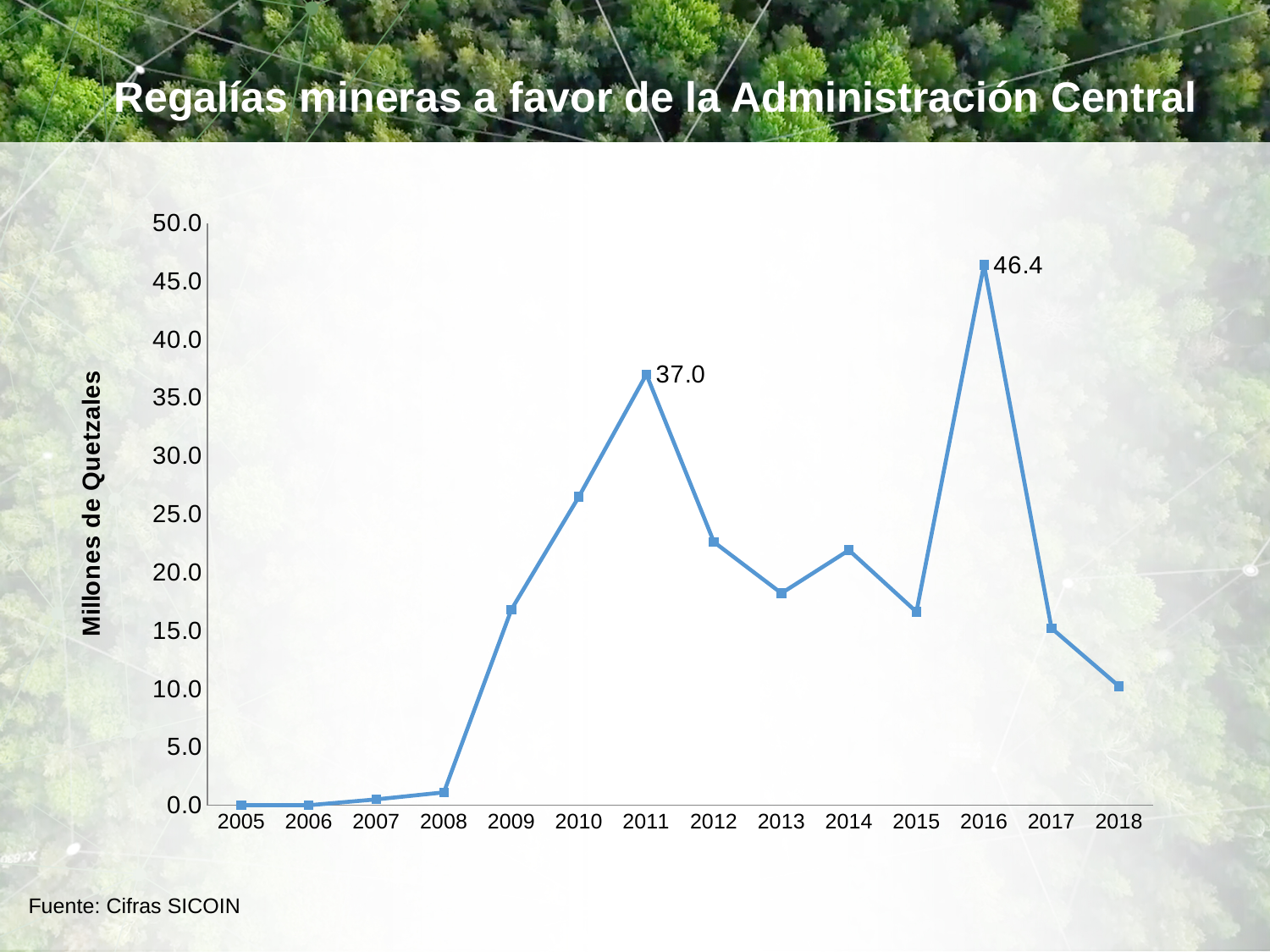
Is the value for 2010 greater or less than 20.0? greater Is the value for 2008 greater or less than 5.0? less Which is larger, the value for 2011 or the value for 2016? 2016 What is the value for 2016? 46.4 Which year has the highest value? 2016 How many years are plotted on the x axis? 14 Do the values rise or fall from 2016 to 2018? fall Is the value for 2018 greater or less than 15.0? less What is the difference between the values for 2016 and 2011? 9.4 What is the label of the y axis? Millones de Quetzales What is the value for 2011? 37.0 What kind of chart is shown on the slide? line chart